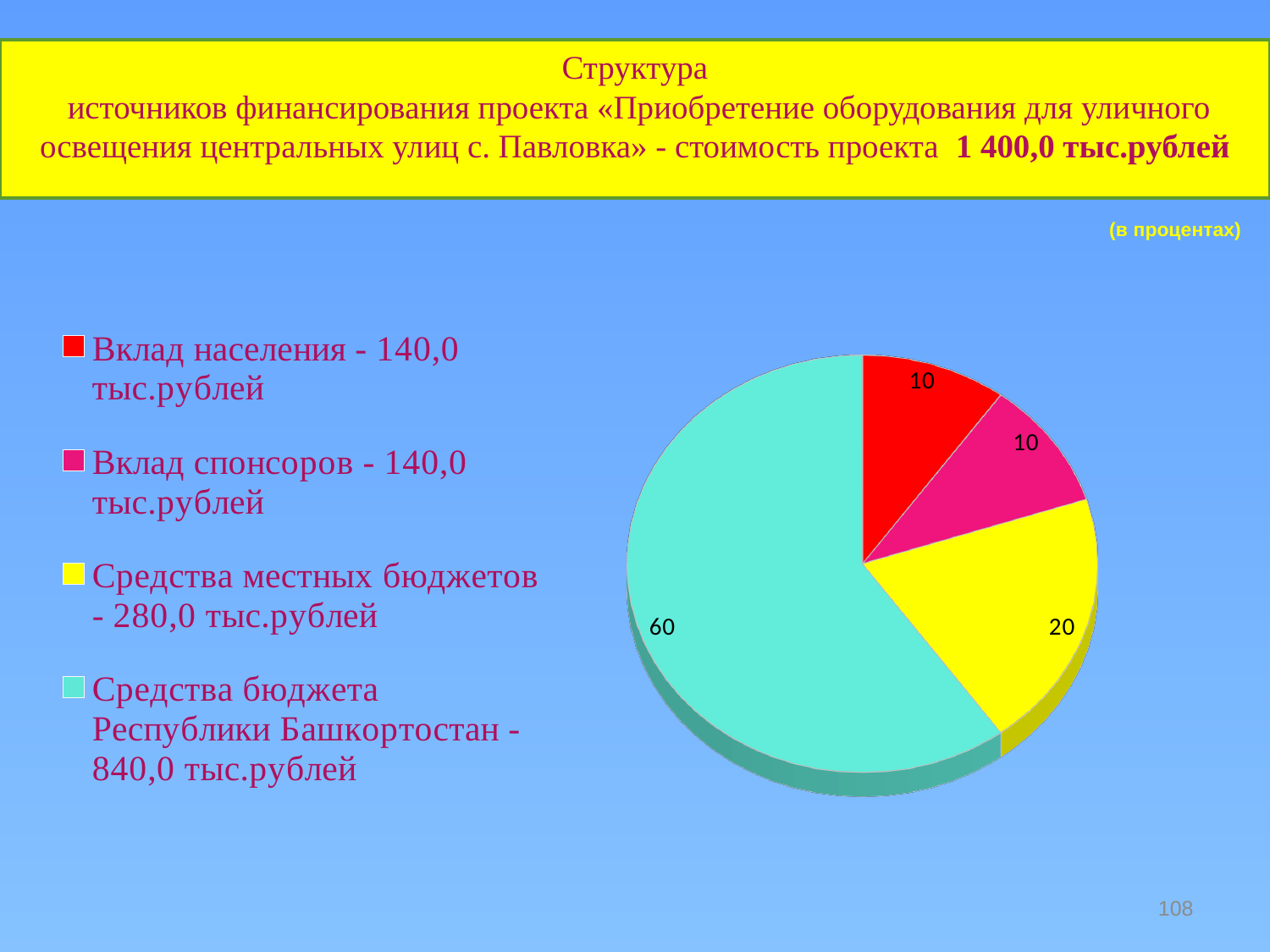
What percentage does the slice for «Средства бюджета Республики Башкортостан» show? 60 What kind of chart is shown on the slide? Pie chart According to the legend, what amount in тыс.рублей corresponds to «Средства бюджета Республики Башкортостан»? 840,0 тыс.рублей What share of the pie do «Вклад населения» and «Вклад спонсоров» make up together? 20 What percentage does the slice for «Средства местных бюджетов» show? 20 Which slice is larger: «Средства местных бюджетов» or «Вклад спонсоров»? Средства местных бюджетов How many slices does the pie chart have? 4 Which funding source has the largest slice of the pie? Средства бюджета Республики Башкортостан What percentage does the slice for «Вклад населения» show? 10 How many entries does the legend list? 4 What colour is the slice for «Средства местных бюджетов»? Yellow What is the difference in percentage points between the slice for «Средства бюджета Республики Башкортостан» and the slice for «Средства местных бюджетов»? 40